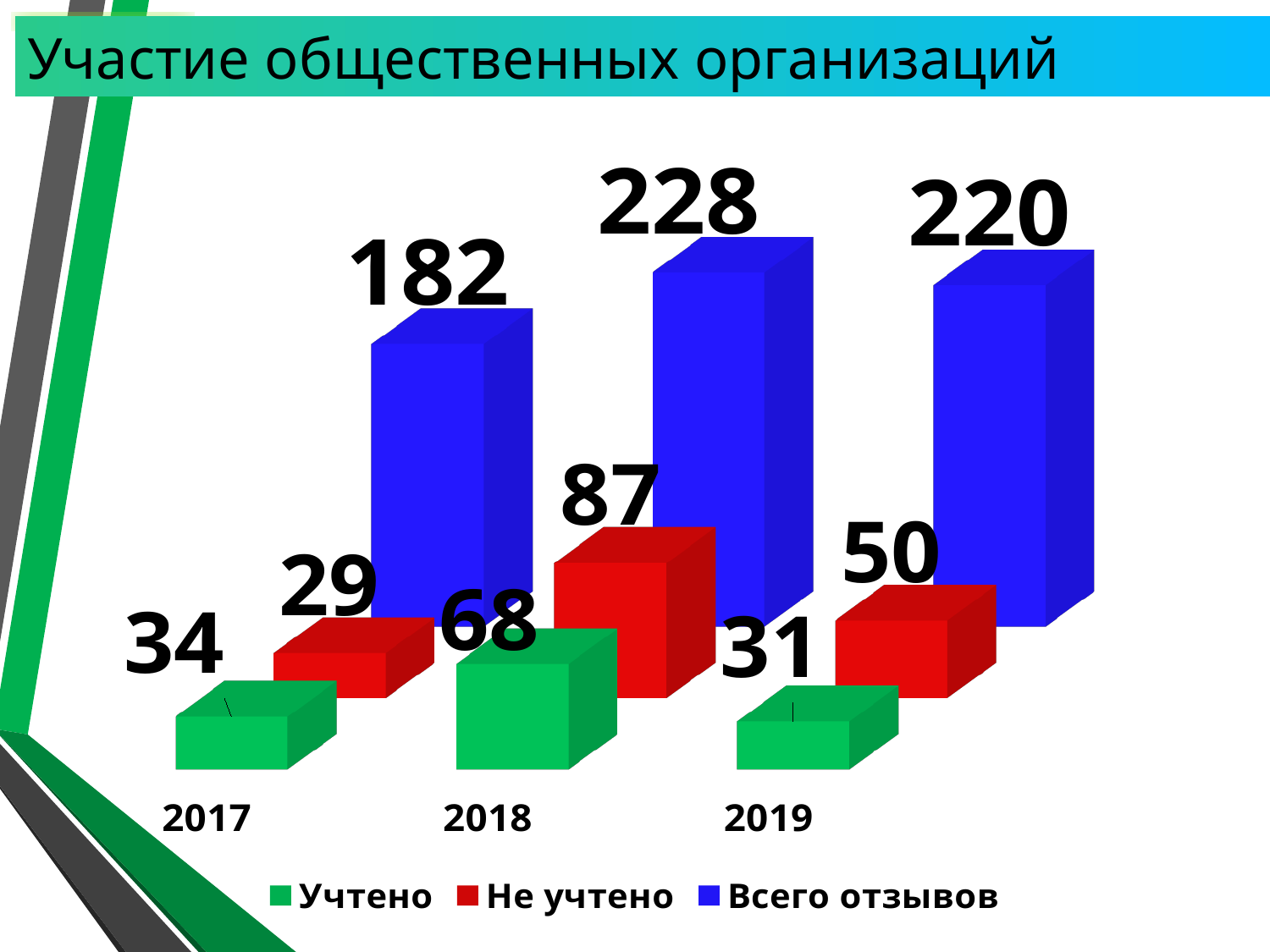
Does Учтено rise or fall from 2018 to 2019? Fall How many series does the legend list? 3 What is the value of Не учтено for 2018? 87 What kind of chart is shown on the slide? Bar chart Which colour represents Всего отзывов in the legend? Blue How many years are shown on the x axis? 3 What is the difference between Всего отзывов in 2018 and in 2017? 46 What is the value of Всего отзывов for 2019? 220 In which year is Не учтено the lowest? 2017 What is the value of Учтено for 2017? 34 In which year is Всего отзывов the highest? 2018 Which is larger in 2019: Учтено or Не учтено? Не учтено